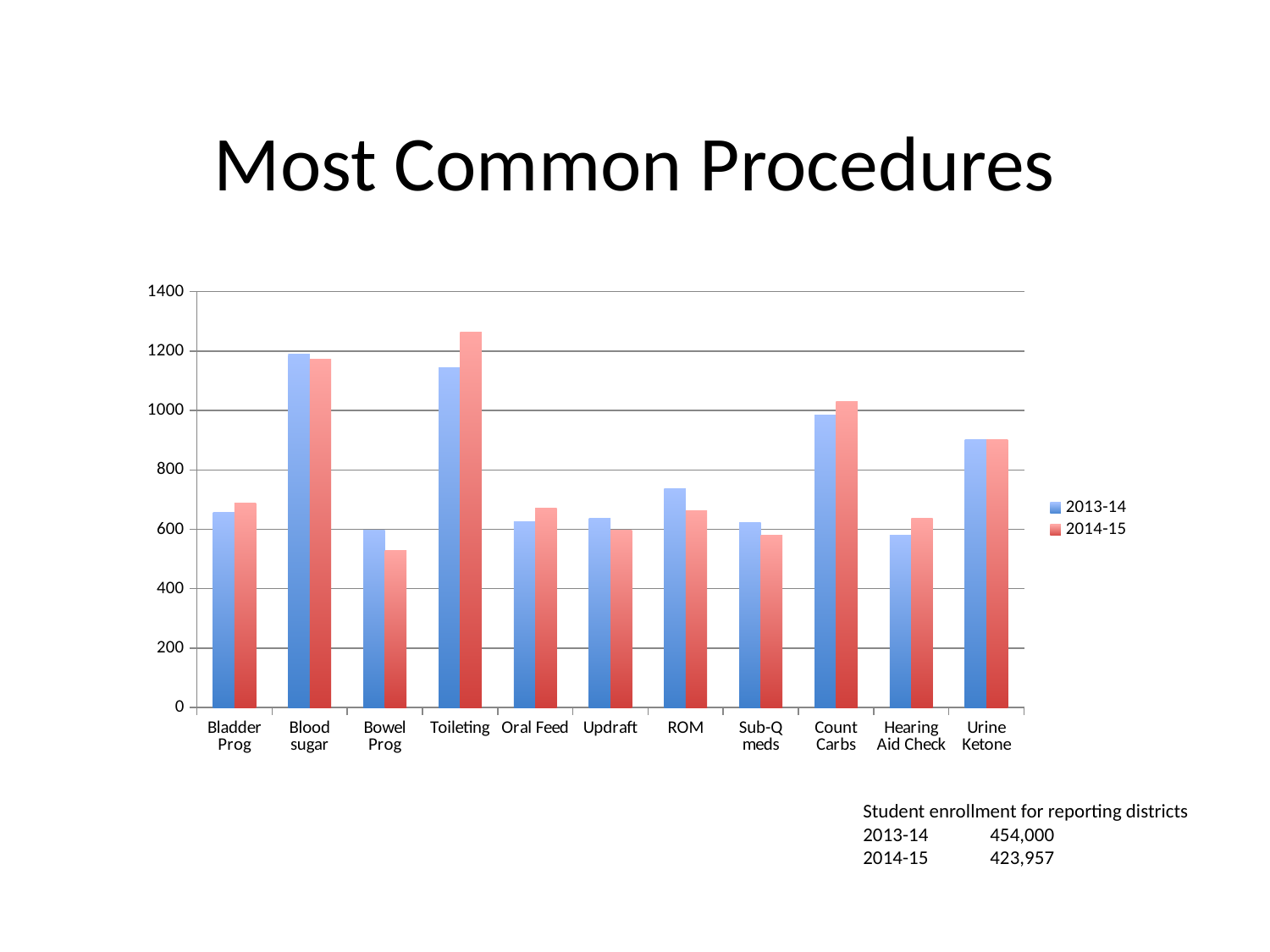
For ROM, which series has the larger value, 2013-14 or 2014-15? 2013-14 Which procedure has the lowest value for 2014-15? Bowel Prog Which procedure has the highest value for 2013-14? Blood sugar Which procedure has the highest value for 2014-15? Toileting For Toileting, which series has the larger value, 2013-14 or 2014-15? 2014-15 How many series does the legend list? 2 Is the 2013-14 value for Count Carbs greater or less than 1000? less Is the 2014-15 value for Toileting greater or less than 1200? greater What kind of chart is shown on the slide? bar chart Is the 2013-14 value for ROM greater or less than 600? greater How many procedure categories are shown on the x axis? 11